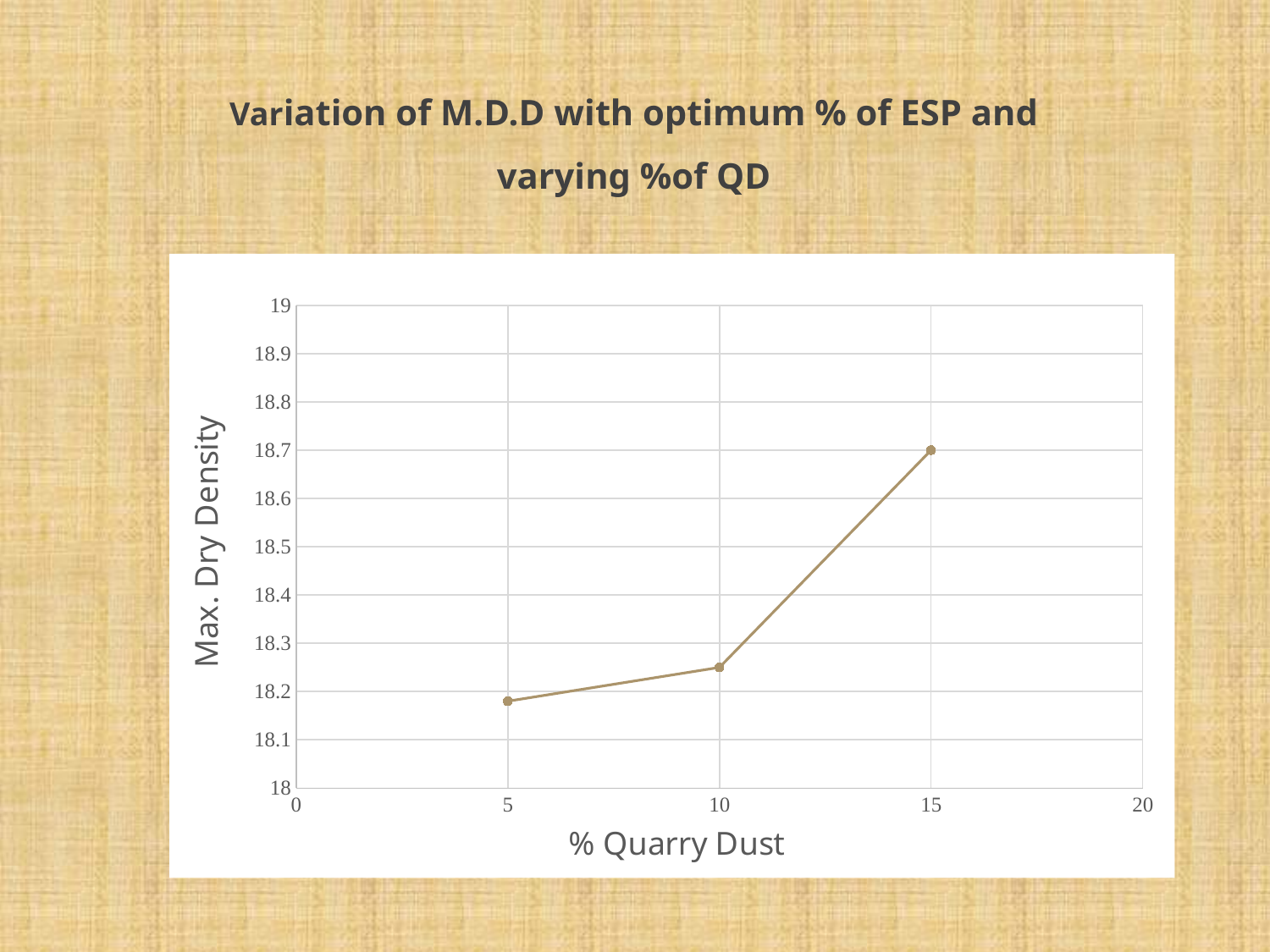
Does the Max. Dry Density rise or fall as % Quarry Dust increases from 5 to 15? rise Which has a higher Max. Dry Density: 10% Quarry Dust or 15% Quarry Dust? 15% Quarry Dust How many data points are plotted on the line? 3 What is the label of the x axis? % Quarry Dust Is the Max. Dry Density at 10% Quarry Dust greater or less than 18.2? greater Is the Max. Dry Density at 10% Quarry Dust greater or less than 18.3? less At which % Quarry Dust is the Max. Dry Density highest? 15 What is the Max. Dry Density at 15% Quarry Dust? 18.7 Is the Max. Dry Density at 5% Quarry Dust greater or less than 18.2? less What kind of chart is shown on the slide? line chart At which % Quarry Dust is the Max. Dry Density lowest? 5 What is the label of the y axis? Max. Dry Density